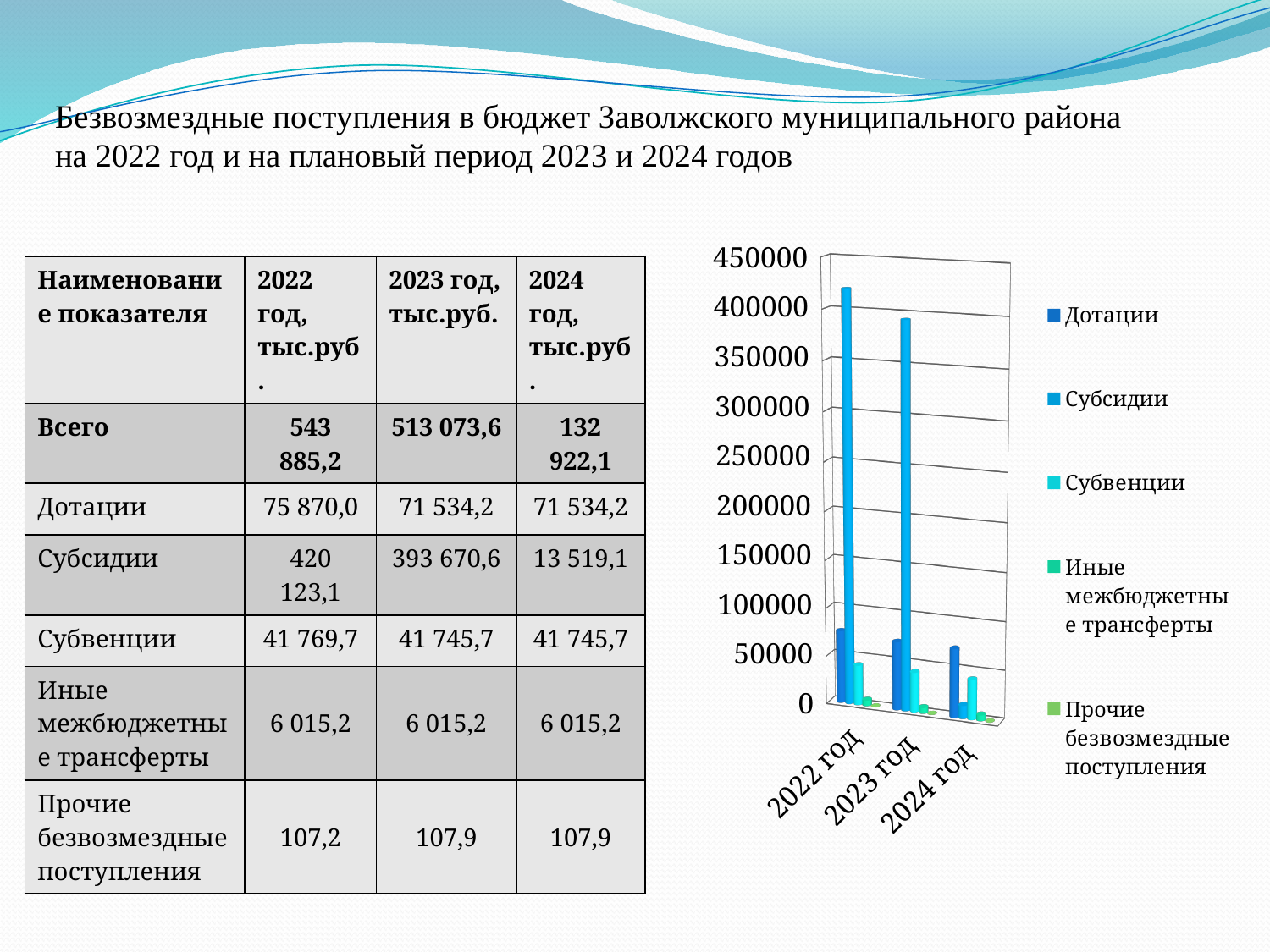
Is the value for Субсидии in 2022 год greater or less than 400000? greater How many series does the chart legend list? 5 Which is larger, the Субсидии bar for 2022 год or for 2024 год? 2022 год Is the value for Дотации in 2022 год greater or less than 100000? less Is the value for Субсидии in 2023 год greater or less than 350000? greater What kind of chart is shown on the right of the slide? bar chart What is the highest value shown on the chart's vertical axis? 450000 Which series has the tallest bar for 2022 год? Субсидии Do the Субсидии values rise or fall from 2022 год to 2024 год? fall Which series has the smallest bar for 2023 год? Прочие безвозмездные поступления How many year categories are shown on the chart's x axis? 3